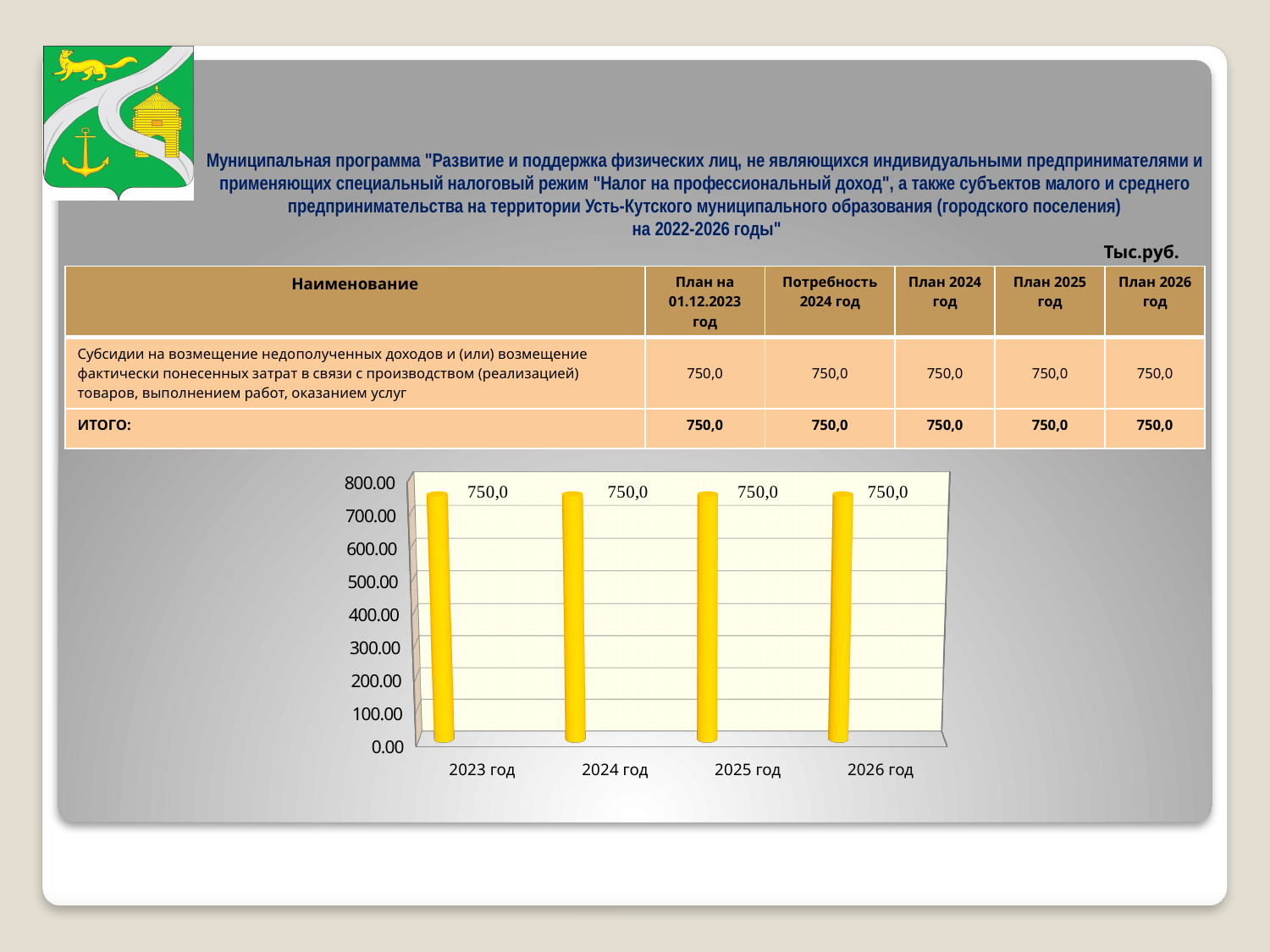
Is the value for 2025 год greater or less than 800.00? less What is the highest value shown on the y axis of the chart? 800.00 What is the value for 2026 год in the chart? 750,0 Is the value for 2024 год greater or less than 700.00? greater What colour are the bars in the chart? yellow What kind of chart is shown on the slide? bar chart How many categories are shown on the x axis of the chart? 4 What is the value for 2024 год in the chart? 750,0 What is the difference between the values for 2023 год and 2026 год? 0,0 What is the value for 2025 год in the chart? 750,0 What is the value for 2023 год in the chart? 750,0 Do the values rise, fall, or stay the same from 2023 год to 2026 год? stay the same